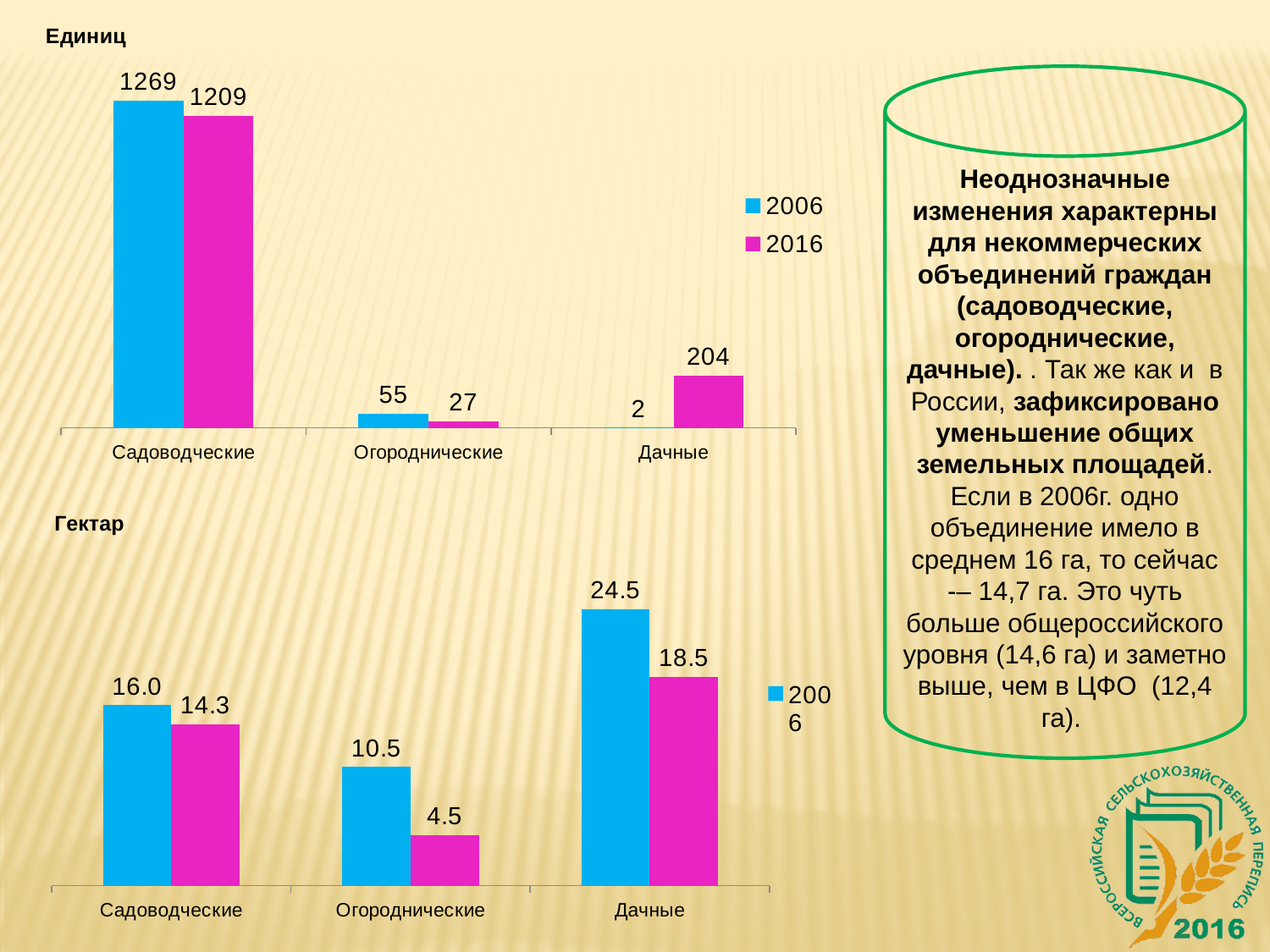
In the bottom chart (Гектар), what is the value for Дачные in 2006? 24.5 What type of chart is the bottom chart (Гектар)? Bar chart In the top chart (Единиц), which category has the lowest 2006 value? Дачные In the top chart (Единиц), what is the value for Огороднические in 2016? 27 In the bottom chart (Гектар), which is larger: the 2006 value for Садоводческие or the 2006 value for Огороднические? Садоводческие In the top chart (Единиц), what is the value for Дачные in 2016? 204 In the bottom chart (Гектар), what is the difference between the 2006 and 2016 values for Огороднические? 6.0 In the bottom chart (Гектар), what is the value for Огороднические in 2016? 4.5 In the top chart (Единиц), what is the value for Садоводческие in 2006? 1269 In the top chart (Единиц), what is the difference between the 2006 and 2016 values for Садоводческие? 60 In the bottom chart (Гектар), which category has the highest 2016 value? Дачные In the top chart (Единиц), how many series does the legend list? 2